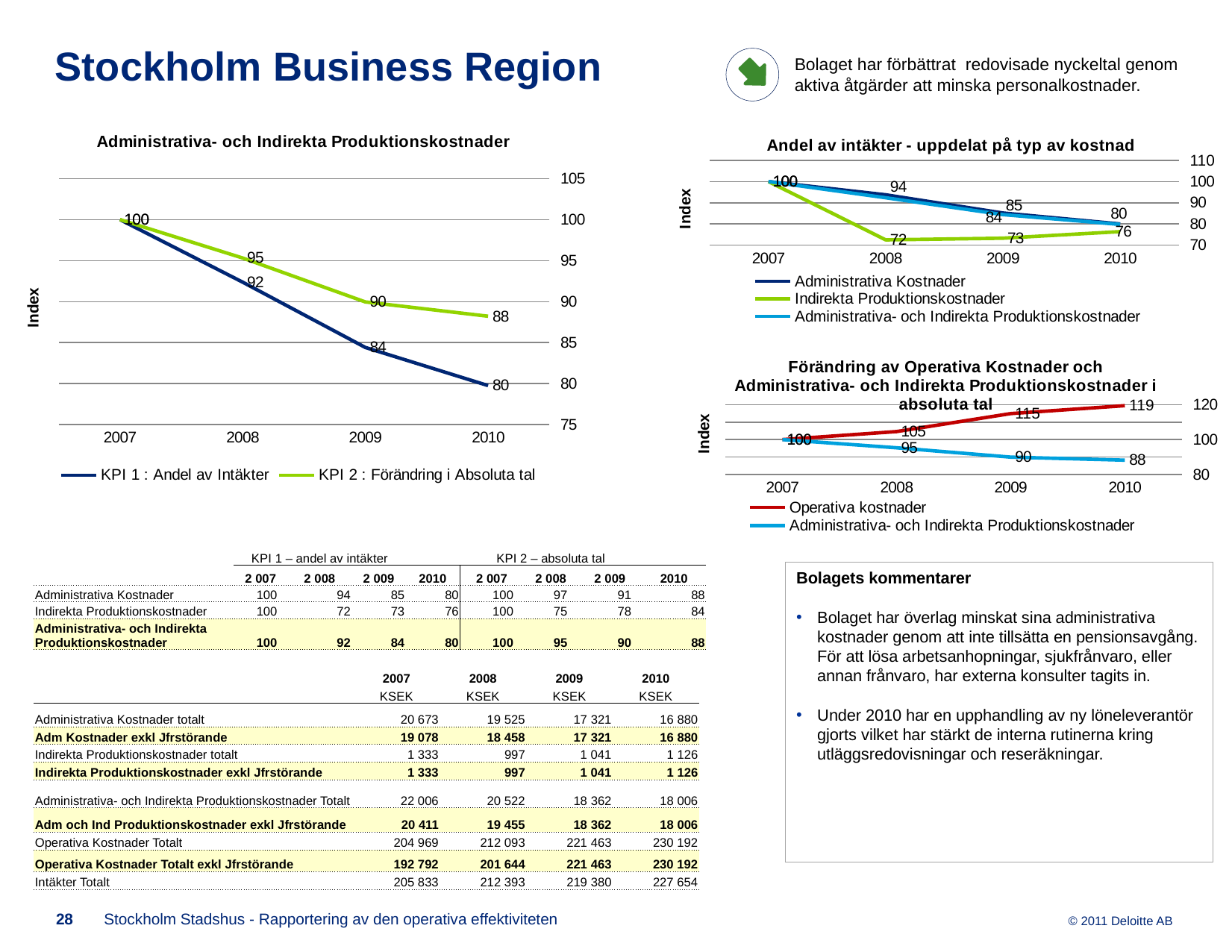
In the chart titled 'Förändring av Operativa Kostnader och Administrativa- och Indirekta Produktionskostnader i absoluta tal', how many years are shown on the x axis? 4 In the chart titled 'Förändring av Operativa Kostnader och Administrativa- och Indirekta Produktionskostnader i absoluta tal', what is the value of Operativa kostnader in 2010? 119 In the chart titled 'Andel av intäkter - uppdelat på typ av kostnad', what is the value of Indirekta Produktionskostnader in 2008? 72 In the chart titled 'Förändring av Operativa Kostnader och Administrativa- och Indirekta Produktionskostnader i absoluta tal', which series is higher in 2009, Operativa kostnader or Administrativa- och Indirekta Produktionskostnader? Operativa kostnader How many series does the legend of the chart titled 'Administrativa- och Indirekta Produktionskostnader' list? 2 In the chart titled 'Andel av intäkter - uppdelat på typ av kostnad', which year has the lowest value for Indirekta Produktionskostnader? 2008 What kind of chart is the chart titled 'Andel av intäkter - uppdelat på typ av kostnad'? line chart In the chart titled 'Administrativa- och Indirekta Produktionskostnader', what is the difference between KPI 2 and KPI 1 in 2008? 3 In the chart titled 'Administrativa- och Indirekta Produktionskostnader', does KPI 1 : Andel av Intäkter rise or fall from 2007 to 2010? fall In the chart titled 'Administrativa- och Indirekta Produktionskostnader', what is the value of KPI 1 : Andel av Intäkter in 2010? 80 In the chart titled 'Administrativa- och Indirekta Produktionskostnader', what is the value of KPI 2 : Förändring i Absoluta tal in 2009? 90 In the chart titled 'Andel av intäkter - uppdelat på typ av kostnad', how many series does the legend list? 3